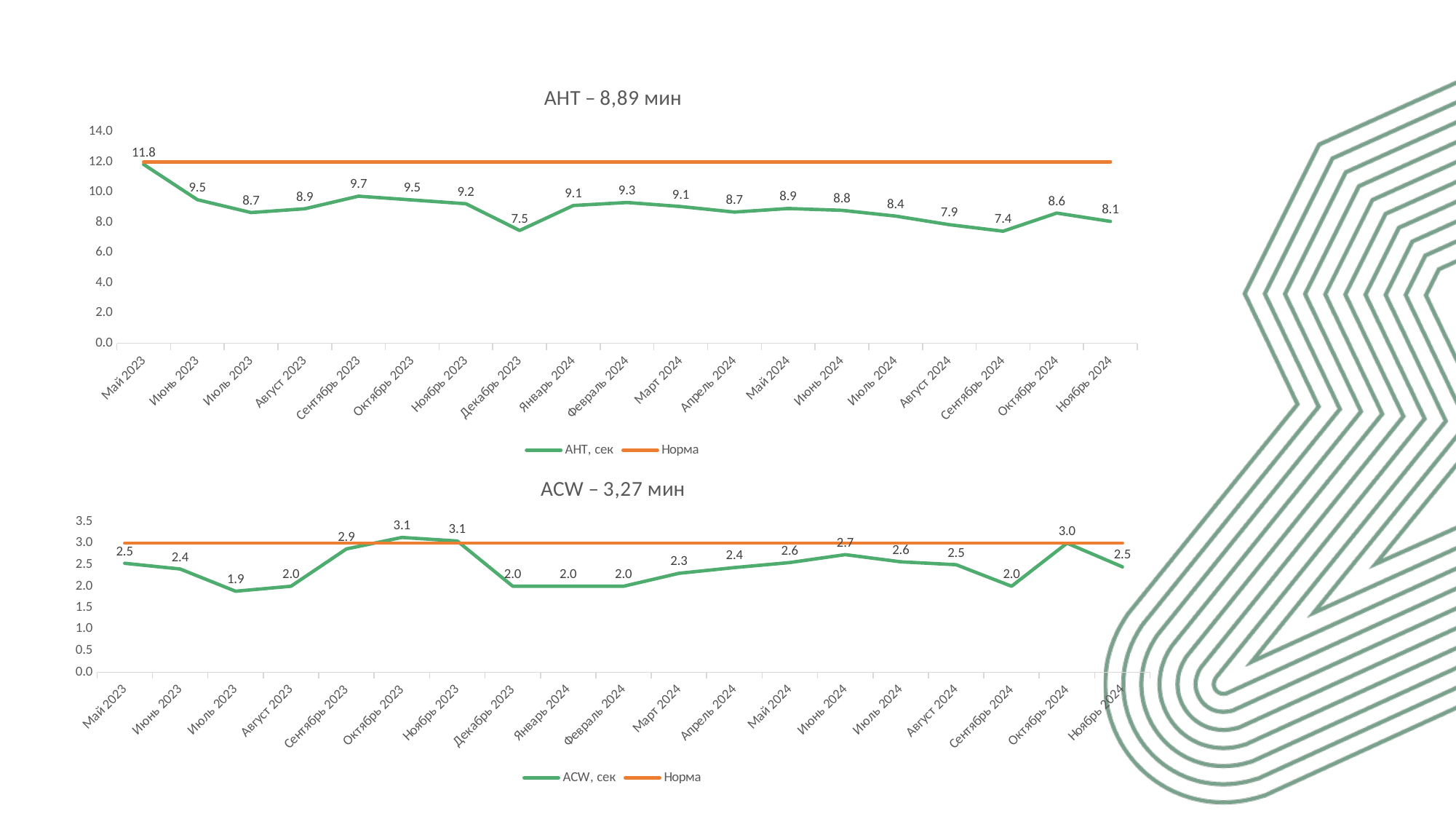
What kind of chart is the ACW – 3,27 мин chart? Line chart In the ACW – 3,27 мин chart, what is the difference between the ACW values for Июнь 2024 and Сентябрь 2024? 0.7 In the AHT – 8,89 мин chart, which month has the highest AHT value? Май 2023 In the AHT – 8,89 мин chart, which month has the lowest AHT value? Сентябрь 2024 In the ACW – 3,27 мин chart, how many months are plotted along the x axis? 19 In the ACW – 3,27 мин chart, which is larger, the ACW value for Сентябрь 2023 or for Март 2024? Сентябрь 2023 In the AHT – 8,89 мин chart, what is the AHT value for Май 2023? 11.8 In the AHT – 8,89 мин chart, what is the difference between the AHT values for Май 2023 and Ноябрь 2024? 3.7 In the ACW – 3,27 мин chart, which month has the lowest ACW value? Июль 2023 In the AHT – 8,89 мин chart, what is the AHT value for Декабрь 2023? 7.5 In the ACW – 3,27 мин chart, what is the ACW value for Октябрь 2024? 3.0 In the AHT – 8,89 мин chart, how many series does the legend list? 2